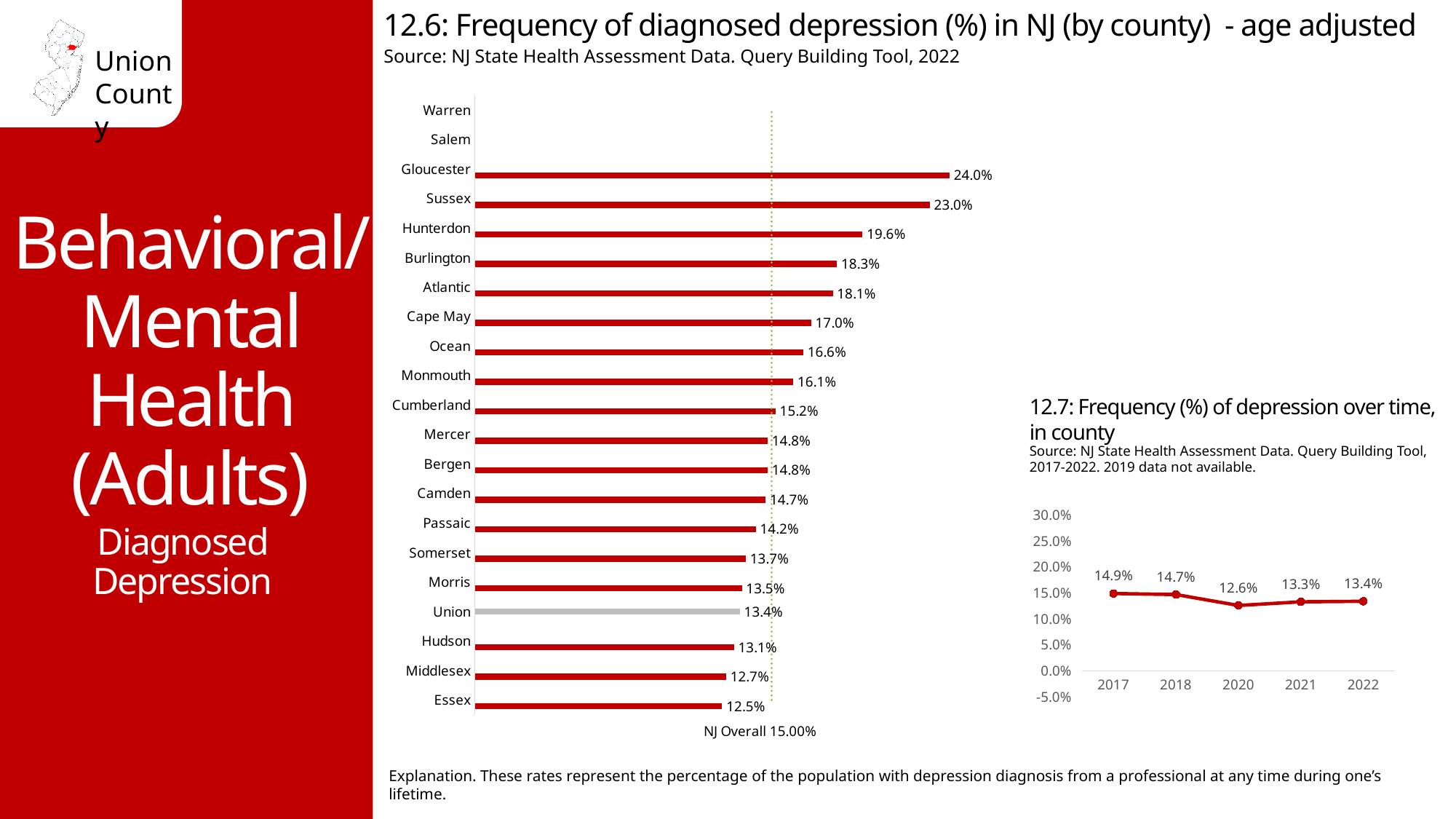
In chart 12.7 (frequency of depression over time in county), how many years are plotted? 5 In chart 12.7 (frequency of depression over time in county), which year has the lowest value? 2020 In chart 12.6 (frequency of diagnosed depression by county), what is the value for Union? 13.4% In chart 12.7 (frequency of depression over time in county), what is the difference between 2017 and 2022? 1.5% In chart 12.6 (frequency of diagnosed depression by county), which county has the highest value? Gloucester In chart 12.6 (frequency of diagnosed depression by county), which is larger, Cape May or Ocean? Cape May In chart 12.6 (frequency of diagnosed depression by county), what is the difference between Sussex and Hunterdon? 3.4% In chart 12.6 (frequency of diagnosed depression by county), what kind of chart is shown? Bar chart In chart 12.6 (frequency of diagnosed depression by county), which county with a plotted bar has the lowest value? Essex In chart 12.6 (frequency of diagnosed depression by county), what NJ overall value is noted below the chart? 15.00% In chart 12.7 (frequency of depression over time in county), what is the value for 2020? 12.6% In chart 12.6 (frequency of diagnosed depression by county), what is the value for Gloucester? 24.0%